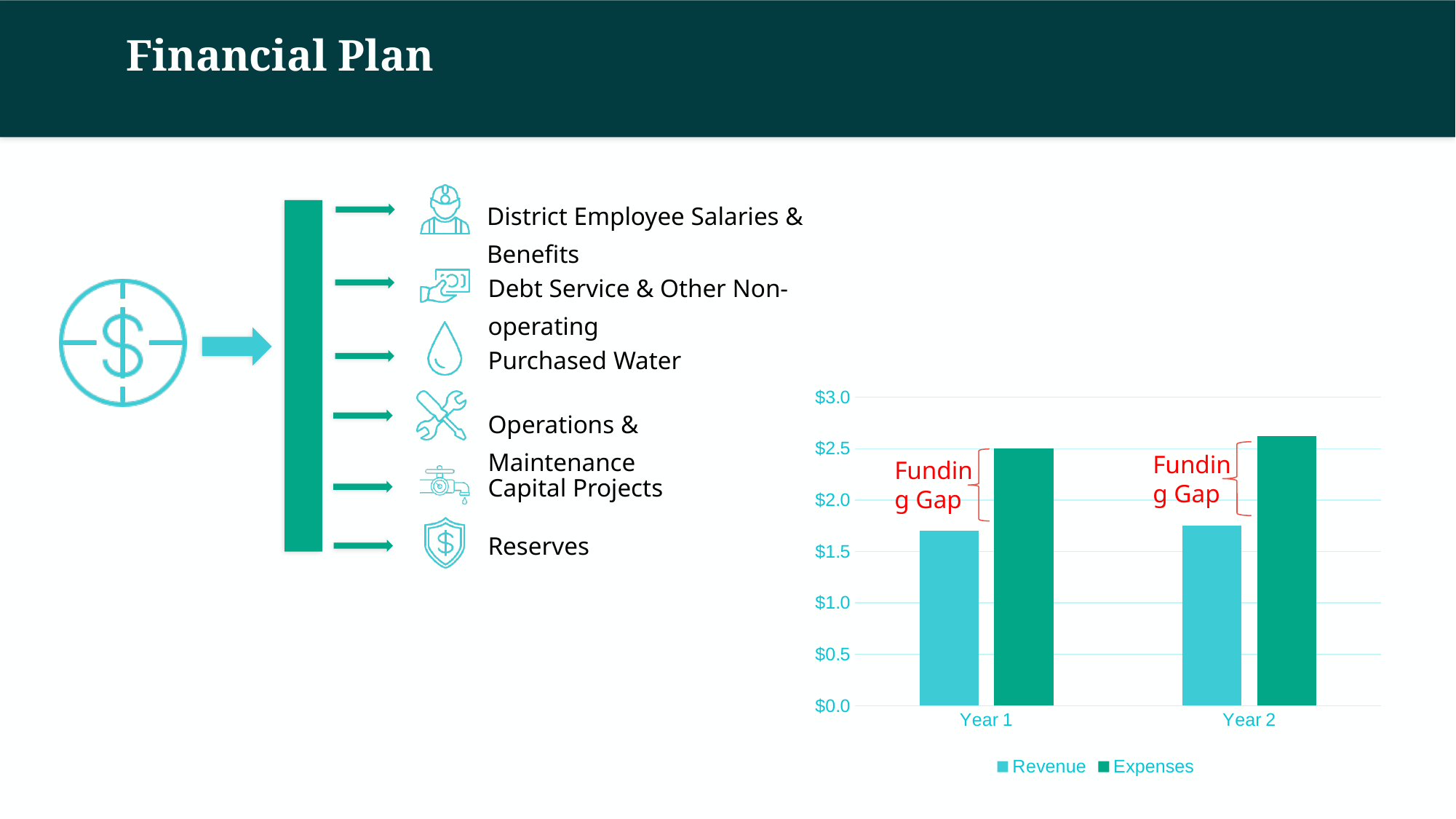
How many series does the chart's legend list? 2 Is the Revenue value for Year 2 greater or less than $2.0? less What are the two entries in the chart's legend? Revenue and Expenses Is the Expenses value for Year 2 greater or less than $2.5? greater How many categories are shown on the x axis of the chart? 2 Is the Revenue value for Year 1 greater or less than $2.0? less What label is written in red between the Revenue and Expenses bars for each year? Funding Gap In Year 2, which series has the higher bar? Expenses In Year 1, which is larger, Revenue or Expenses? Expenses What kind of chart is shown on the slide? Bar chart Do Expenses rise or fall from Year 1 to Year 2? rise